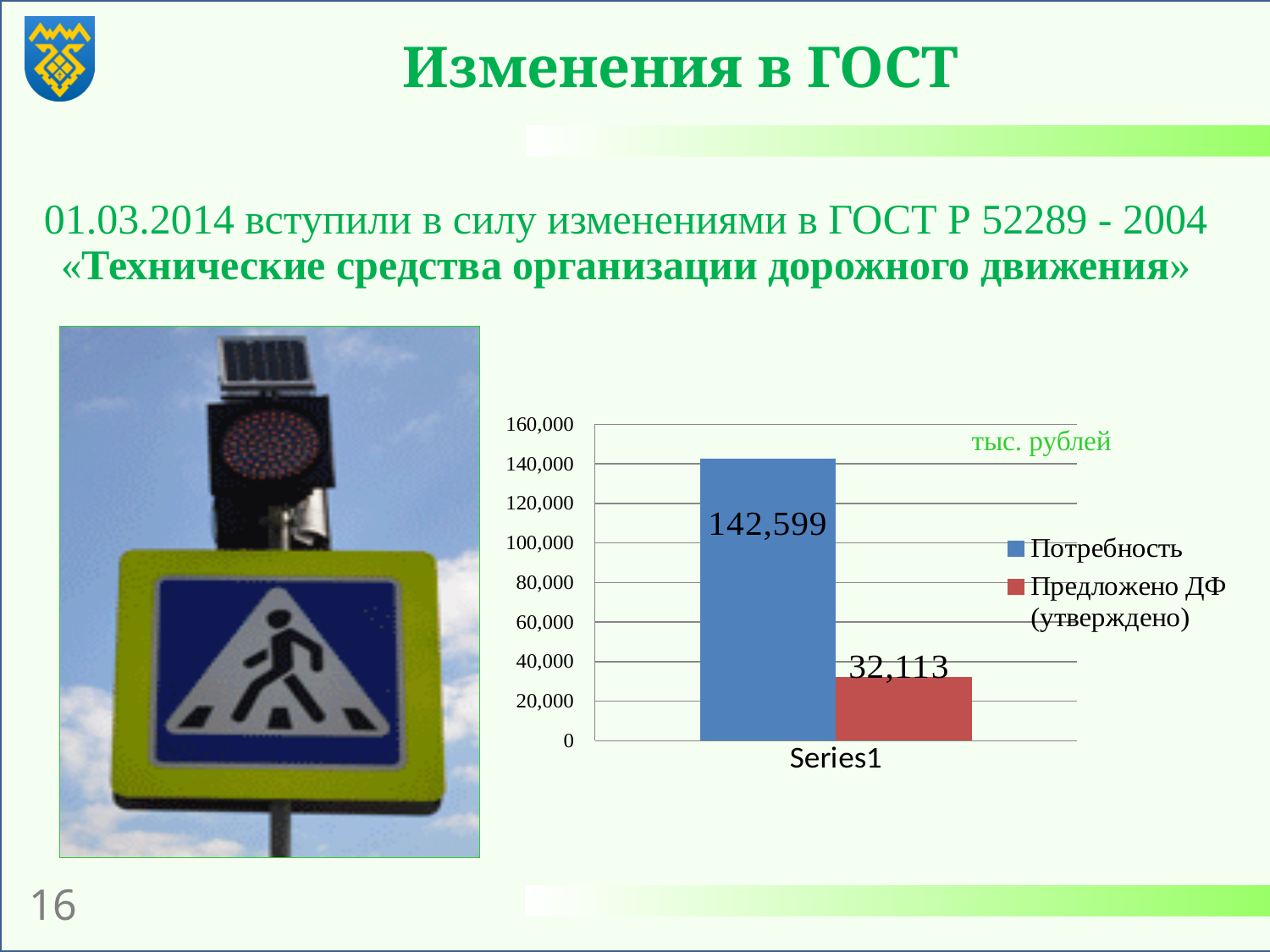
Which series has the highest value on the chart? Потребность Is the value for Потребность greater or less than 140,000? greater What colour is the bar for Потребность? blue What unit is indicated on the chart? тыс. рублей What kind of chart is shown on the slide? bar chart Which series has the higher value, Потребность or Предложено ДФ (утверждено)? Потребность What value is shown for Потребность? 142,599 Which series has the lowest value on the chart? Предложено ДФ (утверждено) How many series does the legend list? 2 Is the value for Предложено ДФ (утверждено) greater or less than 40,000? less What is the difference between the value for Потребность and the value for Предложено ДФ (утверждено)? 110,486 What value is shown for Предложено ДФ (утверждено)? 32,113